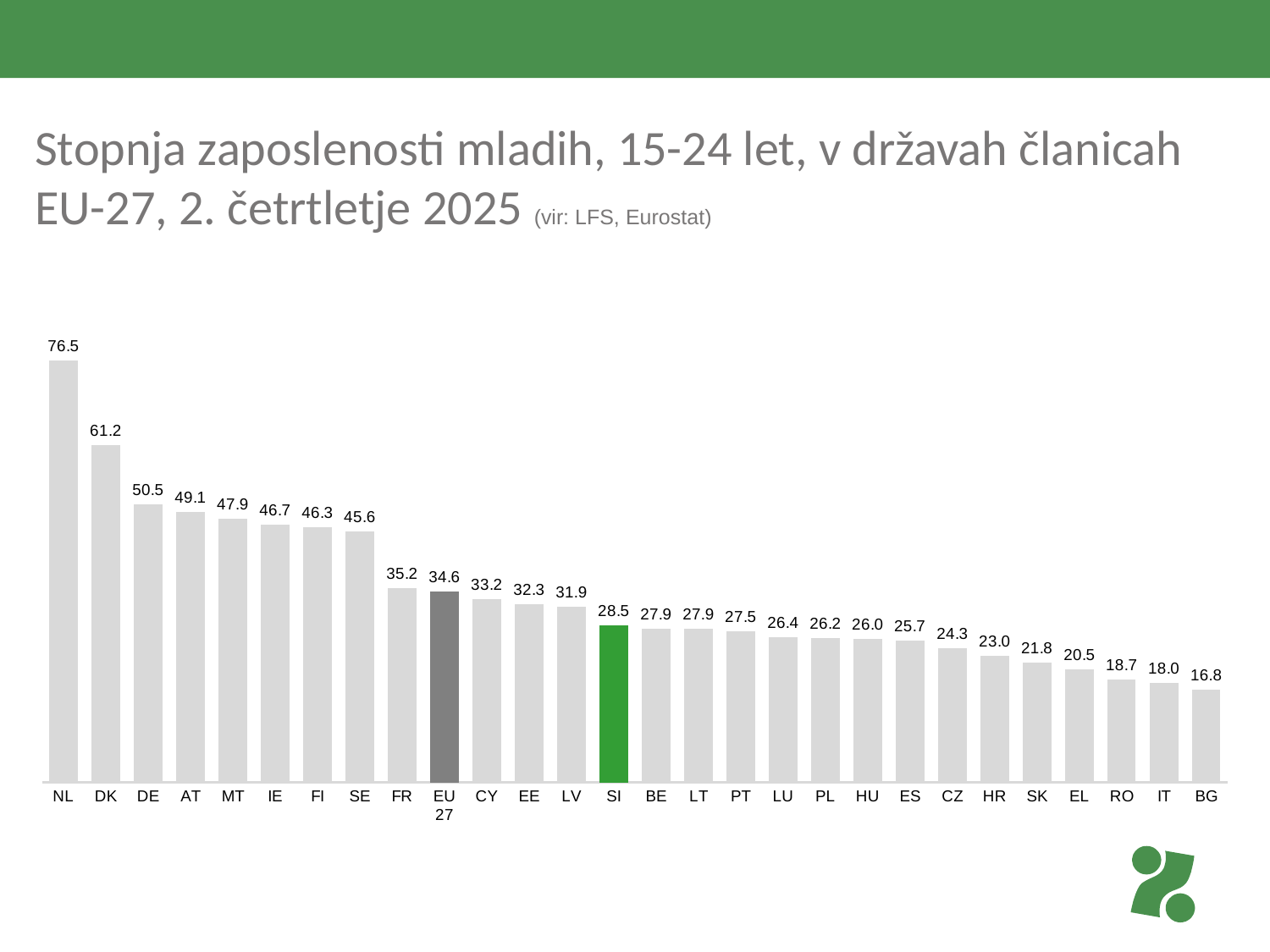
What is the difference between the values for NL and DK? 15.3 What kind of chart is shown on the slide? bar chart What is the value for SI? 28.5 What is the value for EU 27? 34.6 Which is larger, the value for FR or the value for CY? FR Which country has the lowest value? BG What is the difference between the values for EU 27 and SI? 6.1 Which country has the highest value? NL Do the values rise or fall from left to right along the x axis? fall Which bar is coloured green? SI What is the value for NL? 76.5 How many bars are shown in the chart? 28